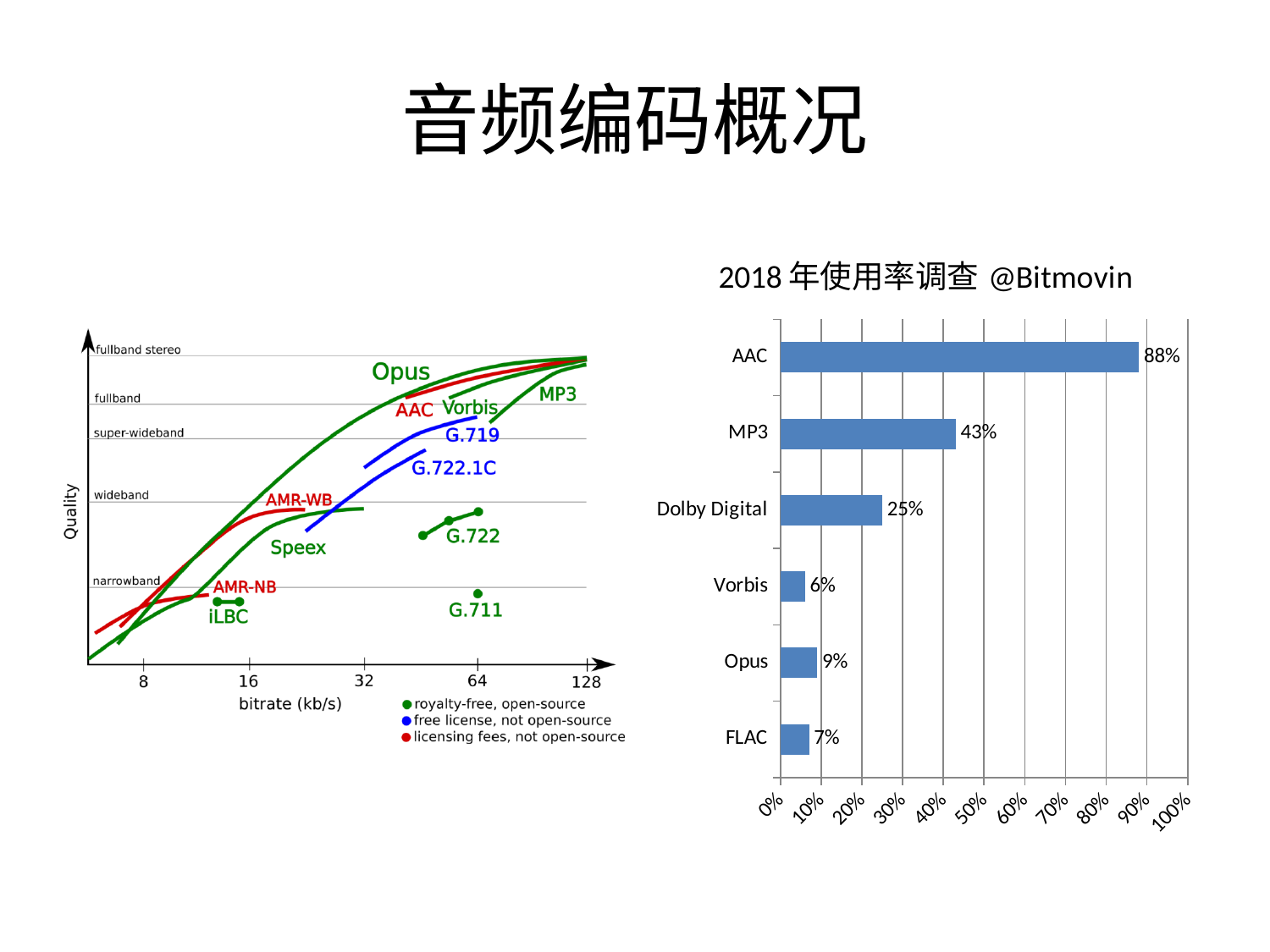
In the chart on the left of the slide, what is the label of the x axis? bitrate (kb/s) How many categories are shown in the bar chart titled 2018 年使用率调查 @Bitmovin? 6 In the bar chart titled 2018 年使用率调查 @Bitmovin, what is the value for Opus? 9% In the bar chart titled 2018 年使用率调查 @Bitmovin, what is the difference between the values for AAC and MP3? 45% What kind of chart is the chart on the right of the slide? bar chart In the bar chart titled 2018 年使用率调查 @Bitmovin, which category has the lowest value? Vorbis In the bar chart titled 2018 年使用率调查 @Bitmovin, which is larger, the value for Opus or the value for FLAC? Opus In the bar chart titled 2018 年使用率调查 @Bitmovin, which category has the highest value? AAC In the bar chart titled 2018 年使用率调查 @Bitmovin, what is the value for Dolby Digital? 25% In the bar chart titled 2018 年使用率调查 @Bitmovin, what is the value for AAC? 88% How many entries does the legend of the chart on the left of the slide list? 3 In the bar chart titled 2018 年使用率调查 @Bitmovin, is the value for MP3 greater or less than 50%? less